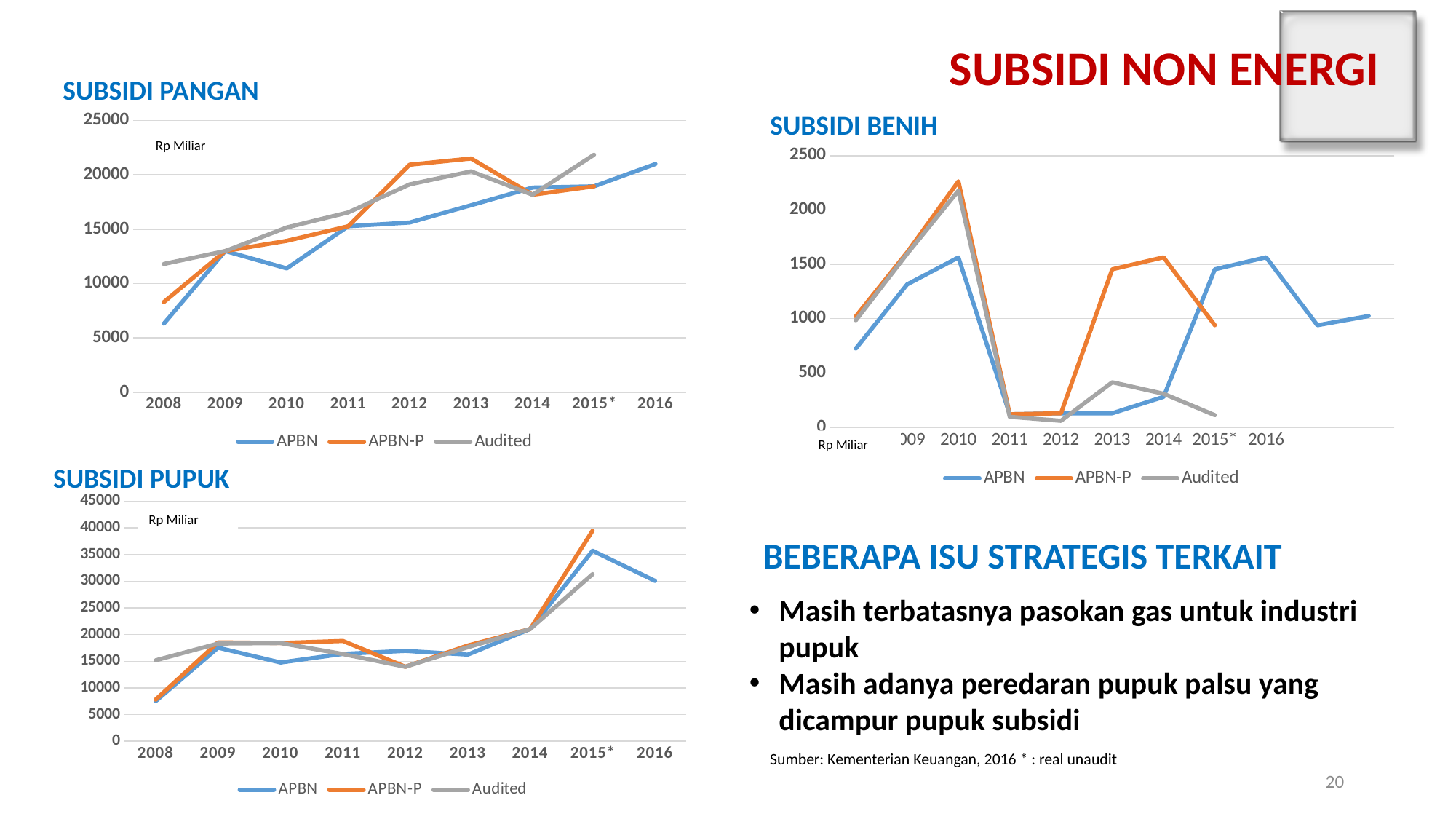
How many series does the legend of the SUBSIDI PUPUK chart list? 3 In the SUBSIDI PANGAN chart, does the APBN series generally rise or fall from 2008 to 2016? rise In the SUBSIDI PANGAN chart, is the APBN value for 2016 greater or less than 20000? greater In the SUBSIDI BENIH chart, which year has the highest APBN-P value? 2010 In the SUBSIDI PANGAN chart, which year has the lowest APBN value? 2008 How many years are shown on the x axis of the SUBSIDI PANGAN chart? 9 What kind of chart is the SUBSIDI PANGAN chart? line chart In the SUBSIDI BENIH chart, is the APBN value for 2011 greater or less than 500? less In the SUBSIDI PUPUK chart, which is larger in 2015*, APBN or APBN-P? APBN-P In the SUBSIDI PUPUK chart, is the APBN-P value for 2015* greater or less than 35000? greater In the SUBSIDI PUPUK chart, which year has the highest APBN-P value? 2015*